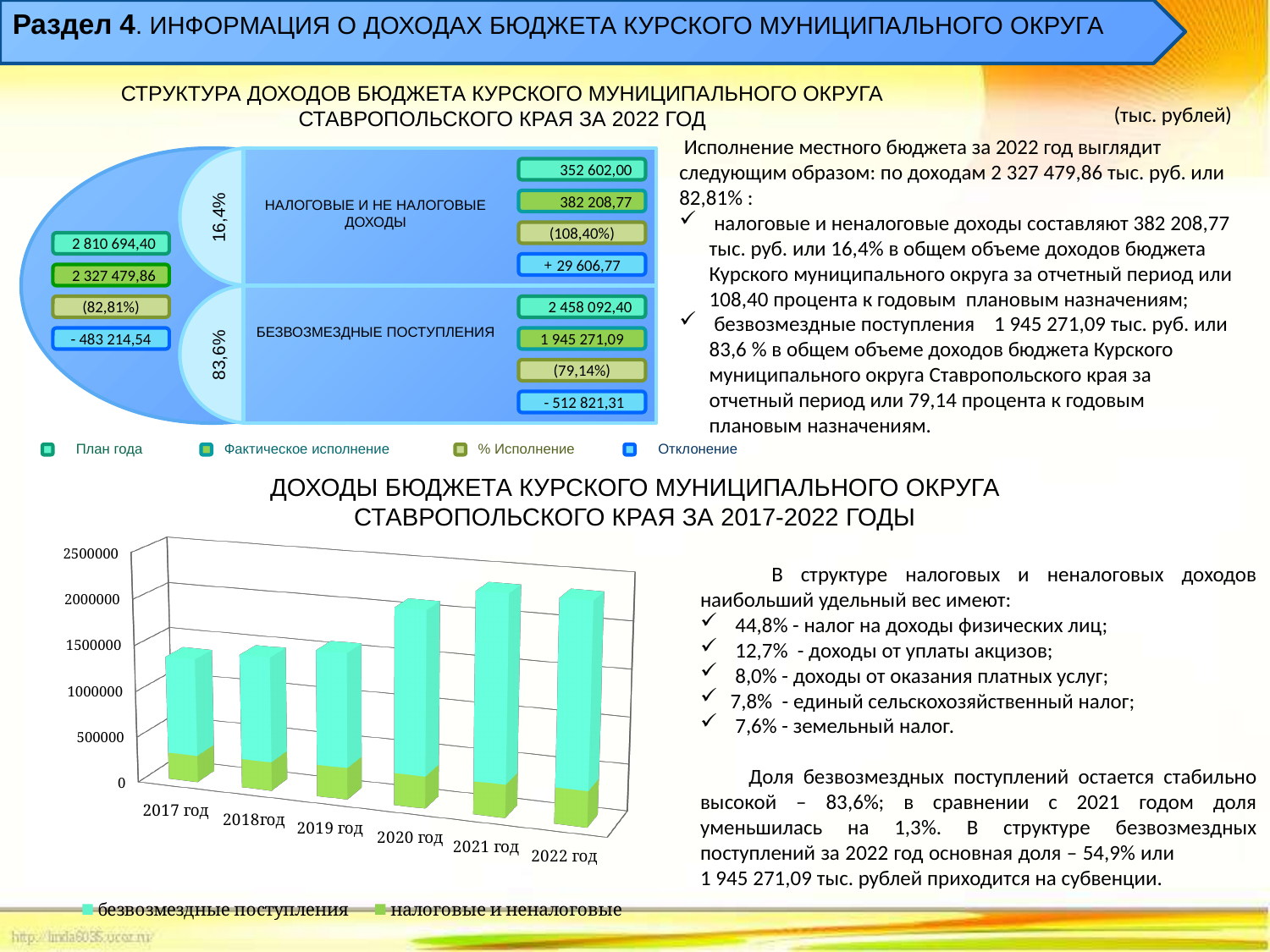
In the bottom bar chart, do the total bars rise or fall from 2017 год to 2021 год? rise In the bottom bar chart, which total bar is taller: 2018год or 2021 год? 2021 год What are the two series named in the legend of the bottom bar chart? безвозмездные поступления; налоговые и неналоговые How many series does the legend of the bottom bar chart list? 2 In the bottom bar chart, is the 'налоговые и неналоговые' portion for 2019 год greater or less than 500000? less In the bottom bar chart, which series makes up the larger part of every bar? безвозмездные поступления How many years (categories) are shown on the x axis of the bar chart at the bottom of the slide? 6 In the bottom bar chart, is the total bar for 2017 год greater or less than 1500000? less In the bottom bar chart, is the total bar for 2021 год greater or less than 2000000? greater What kind of chart is shown under the title 'ДОХОДЫ БЮДЖЕТА КУРСКОГО МУНИЦИПАЛЬНОГО ОКРУГА СТАВРОПОЛЬСКОГО КРАЯ ЗА 2017-2022 ГОДЫ'? Stacked bar chart In the bottom bar chart, which year has the tallest total bar? 2021 год